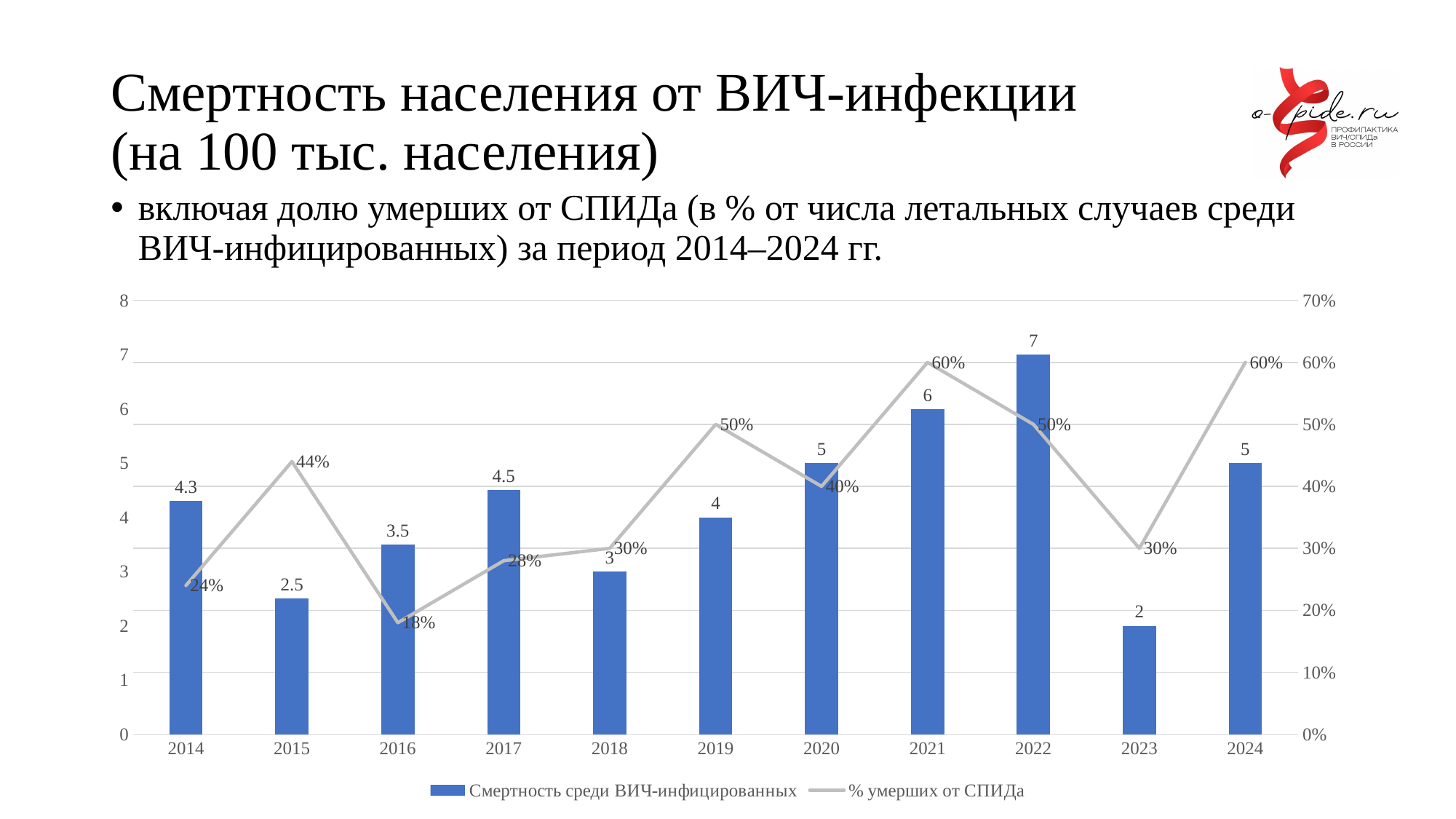
Which year has a larger bar value, 2017 or 2018? 2017 What percentage of deaths from AIDS (% умерших от СПИДа) is shown for 2016? 18% What is the value of the bar for 2014 in the chart? 4.3 What is the difference between the bar values for 2022 and 2023? 5 Which year has the lowest bar for Смертность среди ВИЧ-инфицированных? 2023 How many series does the legend list? 2 Do the bar values rise or fall from 2019 to 2022? rise How many years are shown on the x axis of the chart? 11 What is the value of the bar for 2022? 7 Which year has the highest bar for Смертность среди ВИЧ-инфицированных? 2022 What is the difference between the % умерших от СПИДа values for 2021 and 2020? 20% In which year is the % умерших от СПИДа line at its lowest? 2016